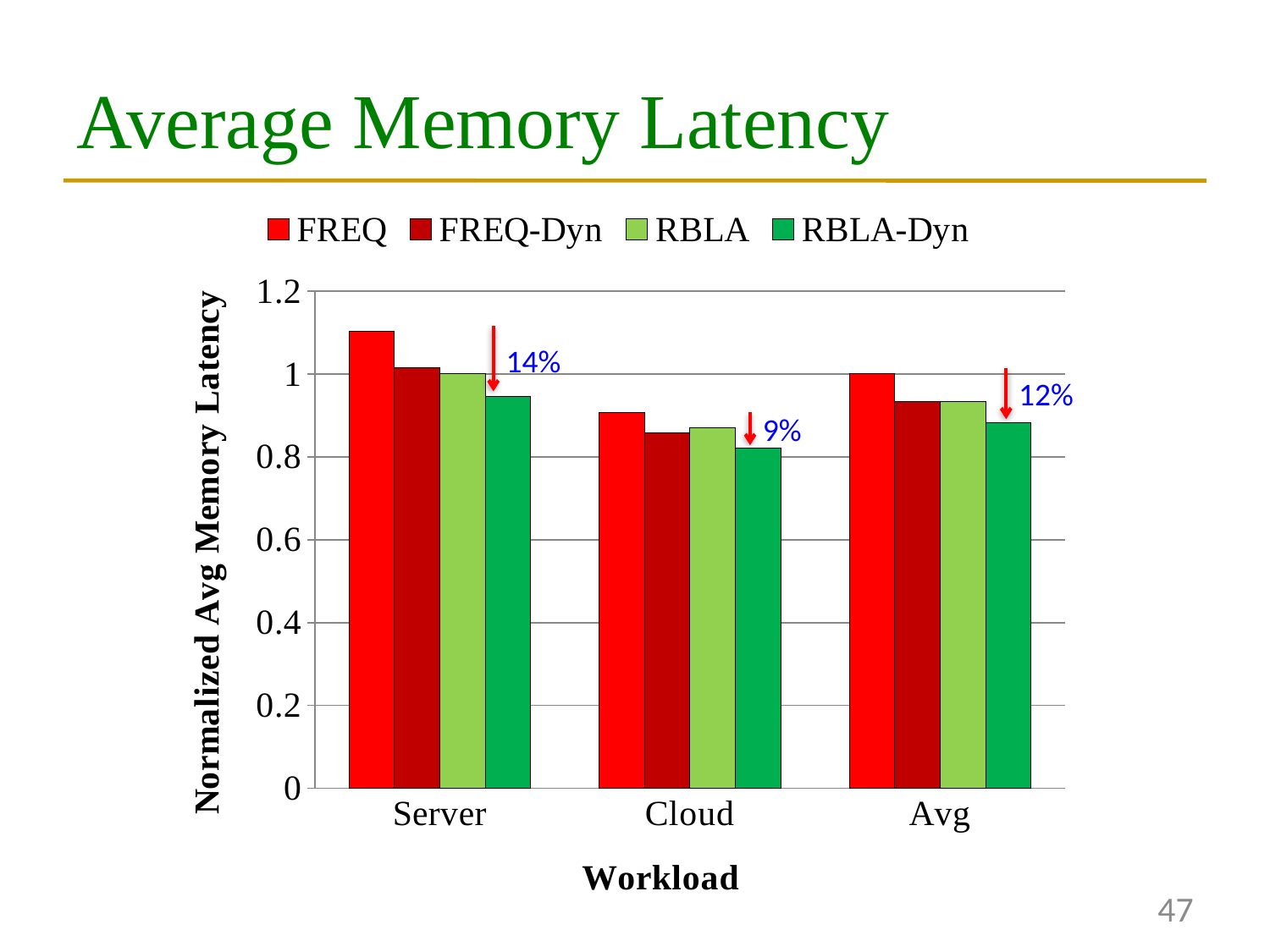
Is the RBLA-Dyn value for Cloud greater or less than 1? less Is the FREQ value for Server greater or less than 1? greater What percentage reduction is annotated for the Avg workload? 12% What percentage reduction is annotated for the Cloud workload? 9% What kind of chart is shown on the slide? bar chart Which series has the highest bar for the Server workload? FREQ How many series does the legend list? 4 Which series has the lowest bar for the Cloud workload? RBLA-Dyn What percentage reduction is annotated above the RBLA-Dyn bar for the Server workload? 14% Which is larger, the FREQ value for Server or the FREQ value for Cloud? Server What is the label of the y axis? Normalized Avg Memory Latency How many workload categories are shown on the x axis? 3